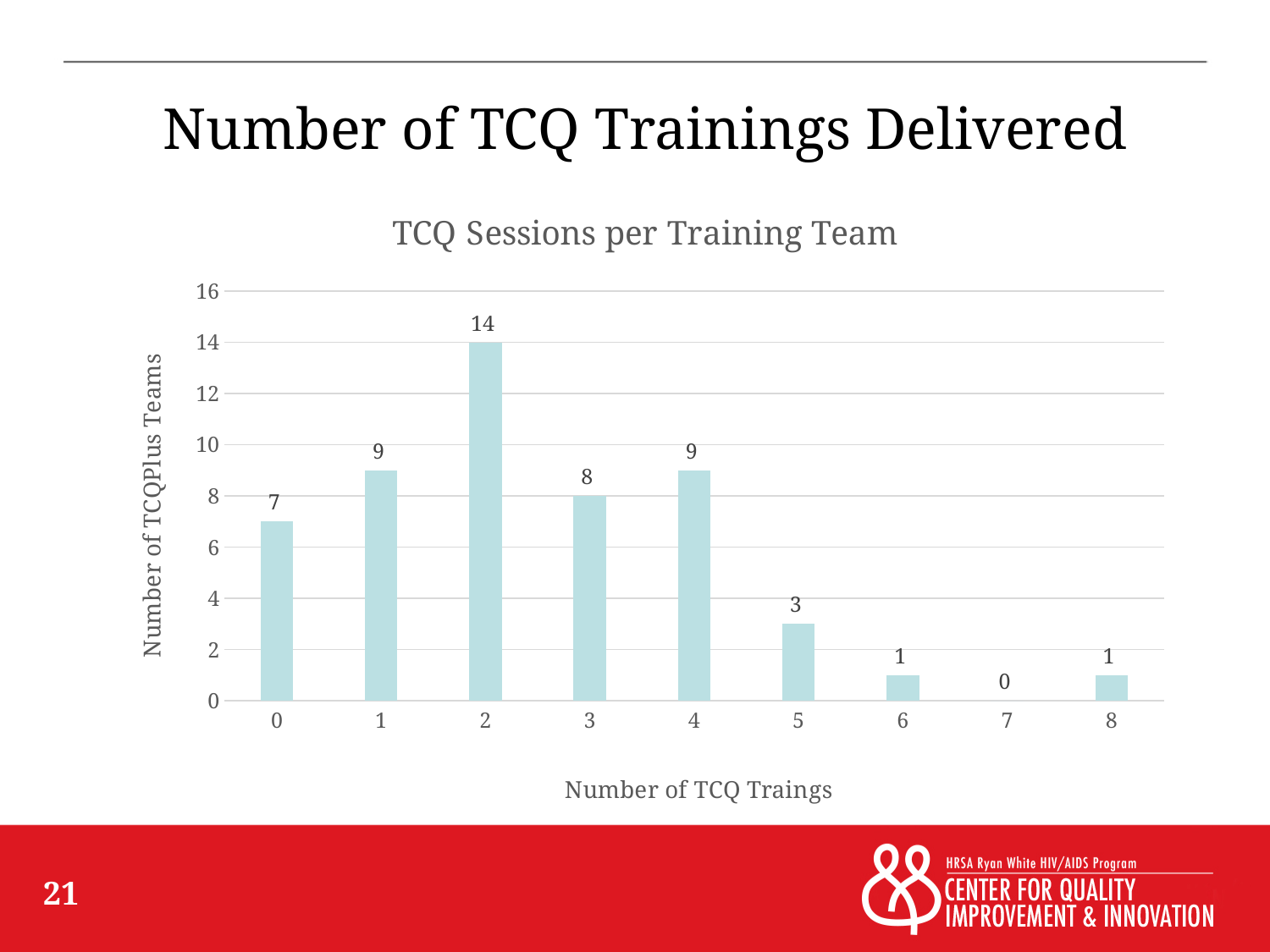
Which number of TCQ trainings has the lowest number of TCQPlus teams? 7 What is the difference between the number of teams with 2 trainings and the number with 3 trainings? 6 What kind of chart is shown on the slide? Bar chart How many TCQPlus teams delivered 0 TCQ trainings? 7 How many categories are shown on the x axis of the chart? 9 Do the values rise or fall from 4 trainings to 7 trainings? Fall What is the number of TCQPlus teams that delivered 2 TCQ trainings? 14 How many TCQPlus teams delivered 5 TCQ trainings? 3 What is the label of the y axis? Number of TCQPlus Teams What is the title of the chart? TCQ Sessions per Training Team Which has more TCQPlus teams: 1 training or 3 trainings? 1 training Which number of TCQ trainings has the highest number of TCQPlus teams? 2